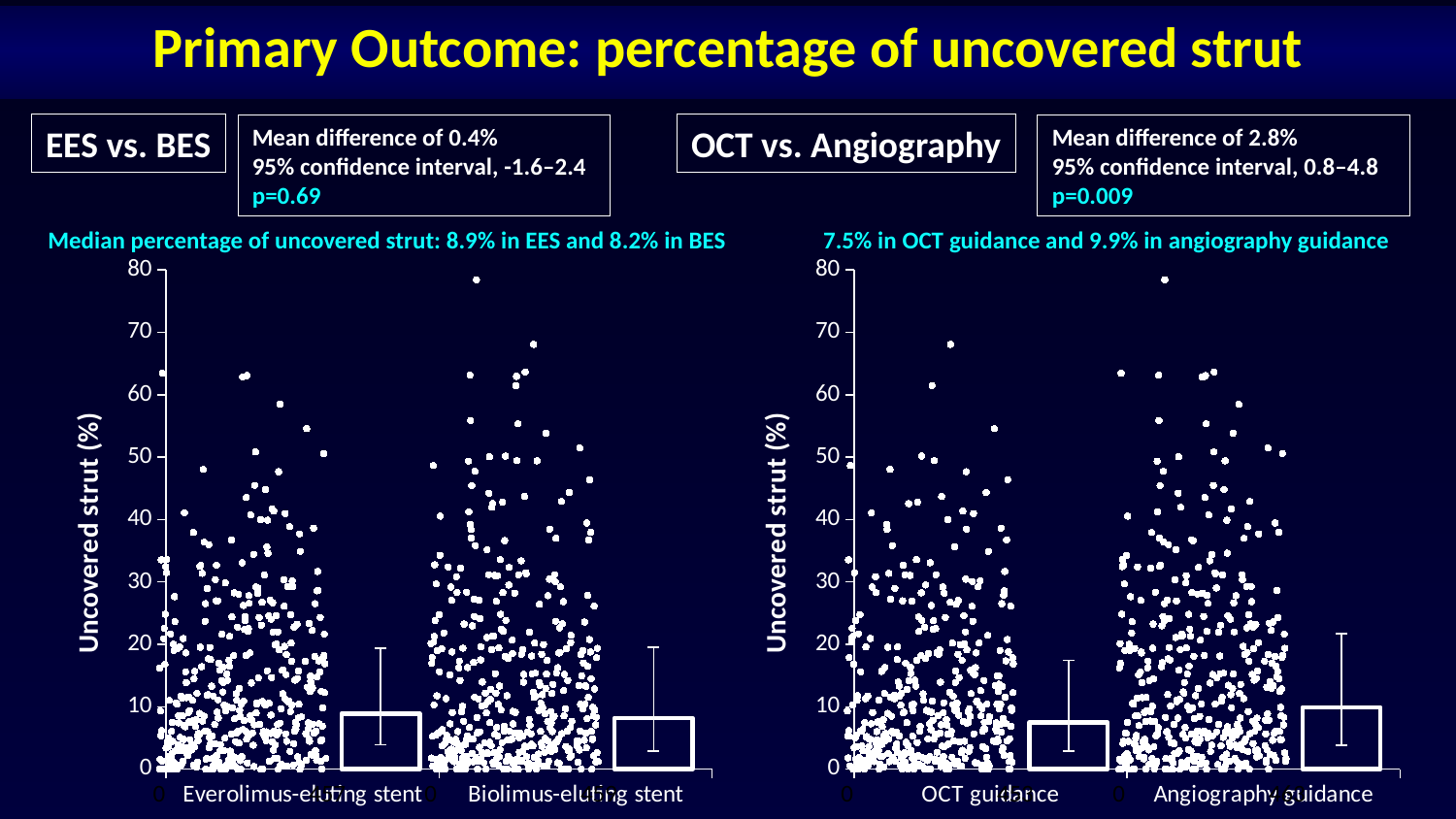
On the right chart (OCT vs. Angiography), what is the median percentage of uncovered strut with OCT guidance? 7.5% On the left chart (EES vs. BES), is the median percentage of uncovered strut for the everolimus-eluting stent greater or less than 10? less On the right chart (OCT vs. Angiography), what is the difference between the median percentages of uncovered strut for angiography guidance and OCT guidance? 2.4% What is the maximum value shown on the y axis of the right chart (OCT vs. Angiography)? 80 On the right chart (OCT vs. Angiography), how many groups are plotted along the x axis? 2 On the left chart (EES vs. BES), what is the median percentage of uncovered strut for EES? 8.9% On the right chart (OCT vs. Angiography), which group has the higher median percentage of uncovered strut? Angiography guidance On the right chart (OCT vs. Angiography), what is the median percentage of uncovered strut with angiography guidance? 9.9% On the left chart (EES vs. BES), what is the median percentage of uncovered strut for BES? 8.2% What is the y-axis label on the left chart (EES vs. BES)? Uncovered strut (%) On the left chart (EES vs. BES), is the median for the biolimus-eluting stent greater or less than the median for the everolimus-eluting stent? less On the left chart (EES vs. BES), which group has the lower median percentage of uncovered strut? BES